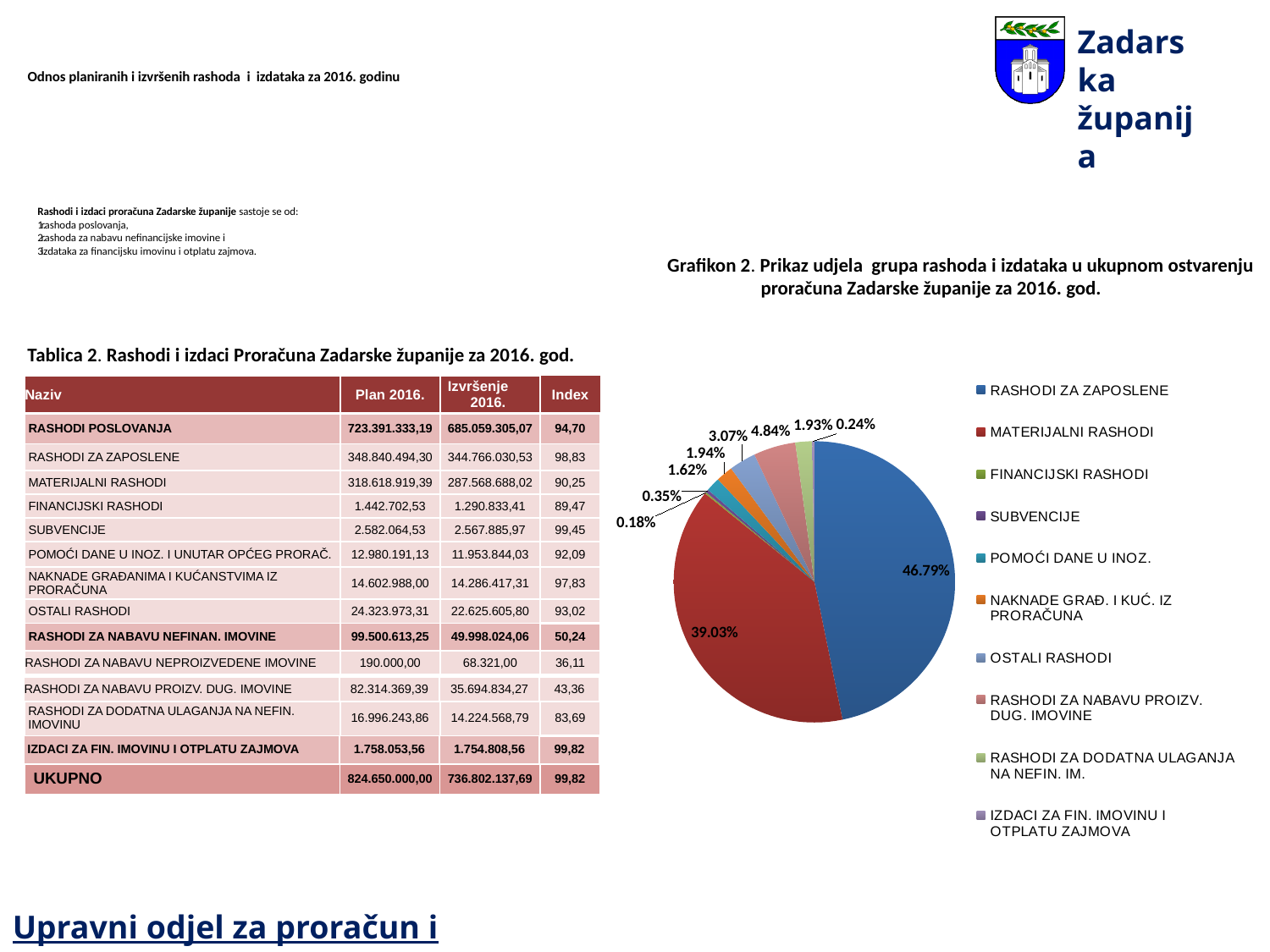
How many categories does the pie chart's legend list? 10 What type of chart is shown on the slide? pie chart Which category has the largest slice of the pie chart? RASHODI ZA ZAPOSLENE Which slice is larger, RASHODI ZA ZAPOSLENE or MATERIJALNI RASHODI? RASHODI ZA ZAPOSLENE What share of the pie does MATERIJALNI RASHODI have? 39.03% What share of the pie does RASHODI ZA ZAPOSLENE have? 46.79% What is the smallest percentage labelled on the pie chart? 0.18% What is the difference in percentage points between the RASHODI ZA ZAPOSLENE slice and the MATERIJALNI RASHODI slice? 7.76 What is the title of the pie chart (Grafikon 2)? Prikaz udjela grupa rashoda i izdataka u ukupnom ostvarenju proračuna Zadarske županije za 2016. god. What colour is the largest slice of the pie chart? blue What is the combined share of the two largest slices, RASHODI ZA ZAPOSLENE and MATERIJALNI RASHODI? 85.82% What share of the pie does RASHODI ZA NABAVU PROIZV. DUG. IMOVINE have? 4.84%